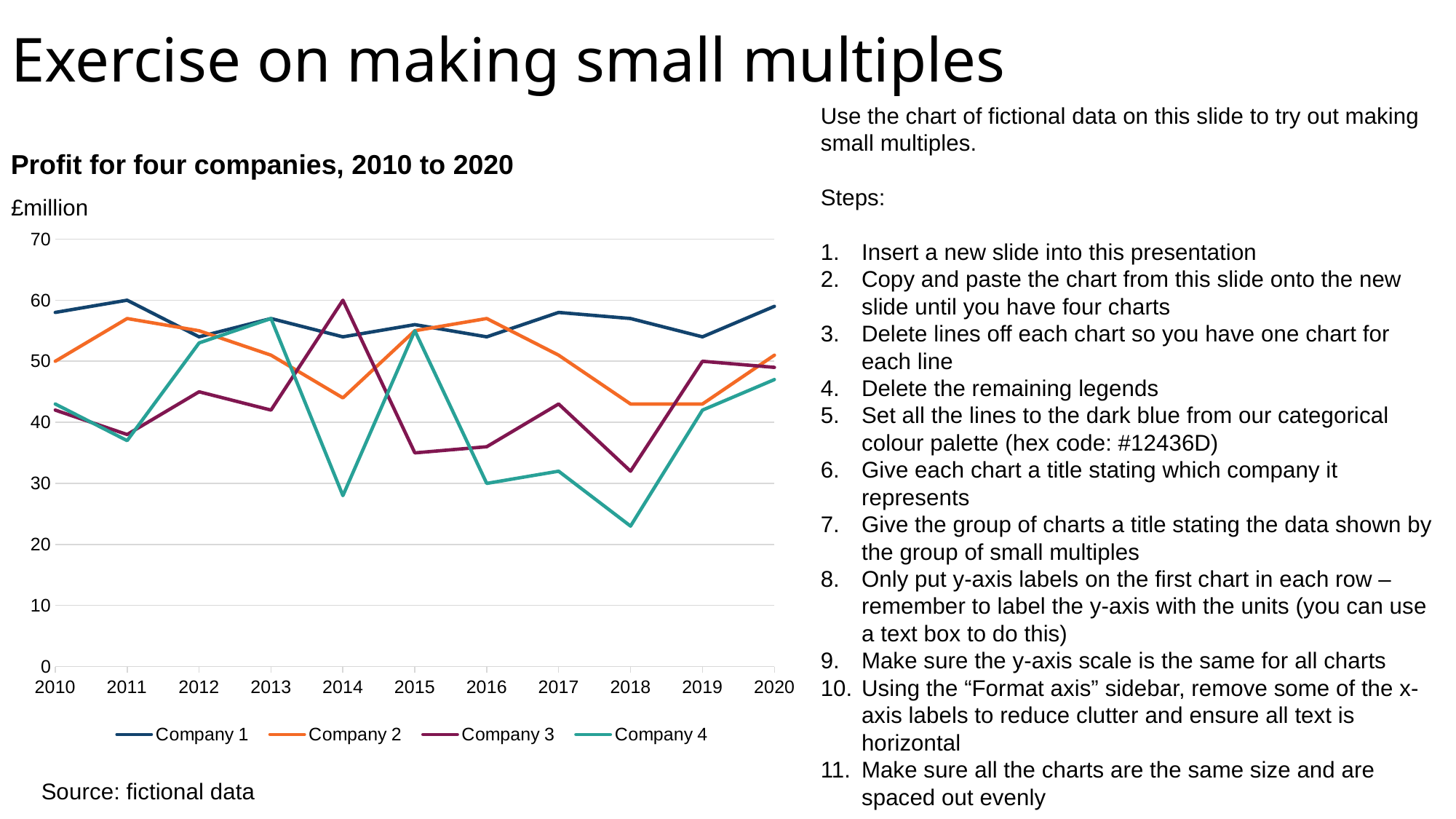
In which year does Company 4 have its lowest value? 2018 What is the title of the chart? Profit for four companies, 2010 to 2020 In 2018, which is larger: the value for Company 1 or the value for Company 4? Company 1 How many series does the chart legend list? 4 What is the value for Company 3 in 2014? 60 Is the value for Company 4 in 2018 greater or less than 30? less How many years are shown along the x axis of the chart? 11 In which year does Company 3 have its highest value? 2014 What is the value for Company 1 in 2011? 60 What unit is shown for the y axis of the chart? £million What is the value for Company 2 in 2010? 50 What kind of chart is shown on the slide? line chart